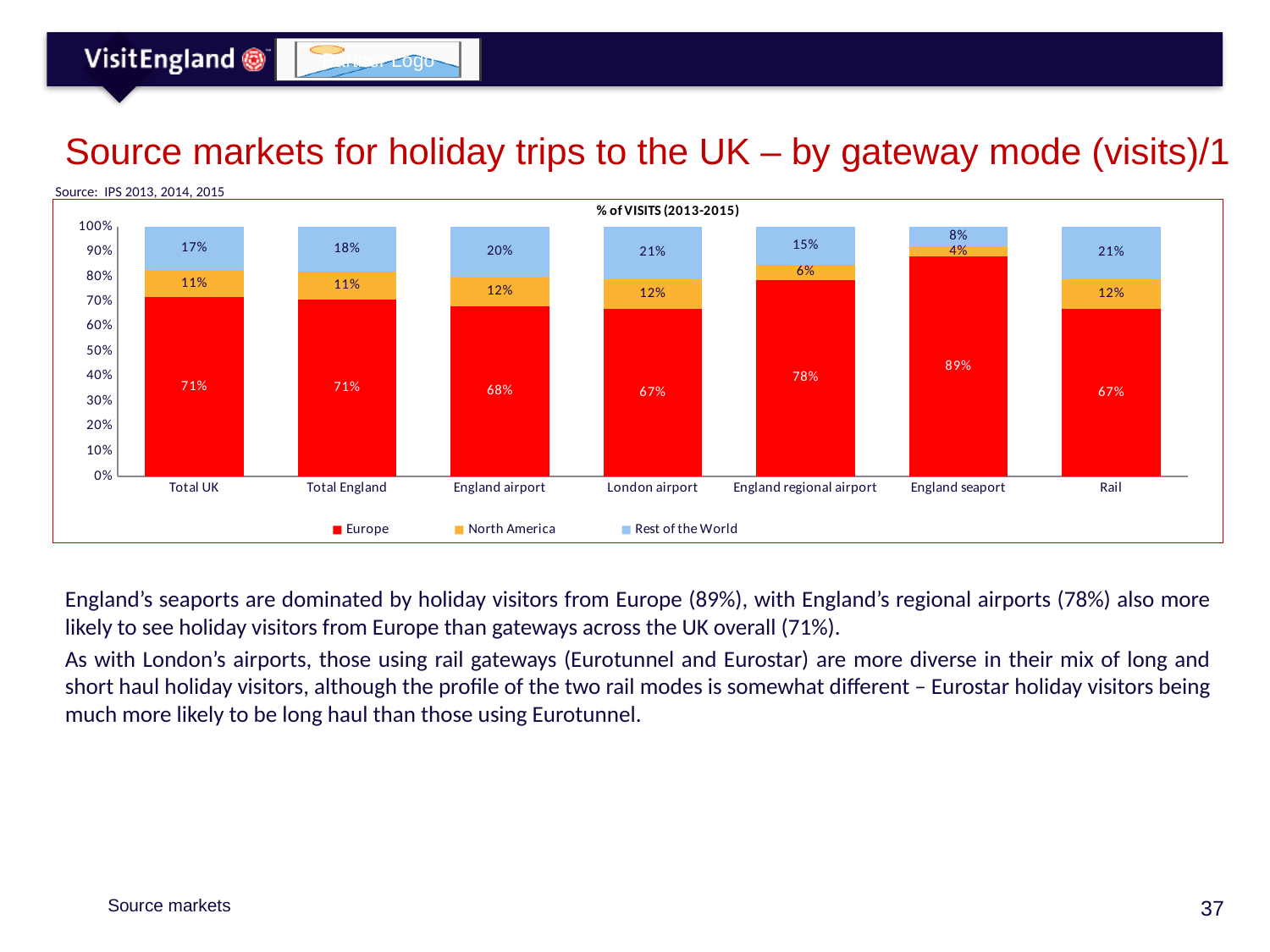
Which colour represents North America in the chart? Orange Which gateway has the lowest North America share? England seaport What percentage of visits to England seaports come from Europe? 89% What is the Rest of the World share for London airport? 21% Is the Rest of the World share larger for Rail or for England regional airport? Rail Which gateway has the highest Europe share? England seaport What kind of chart is shown? Stacked bar chart What is the difference between the Europe share for England seaport and for Total UK? 18 percentage points What is the title of the chart? % of VISITS (2013-2015) What is the North America share for England regional airport? 6% How many series does the legend list? 3 How many gateway categories are shown on the x axis? 7